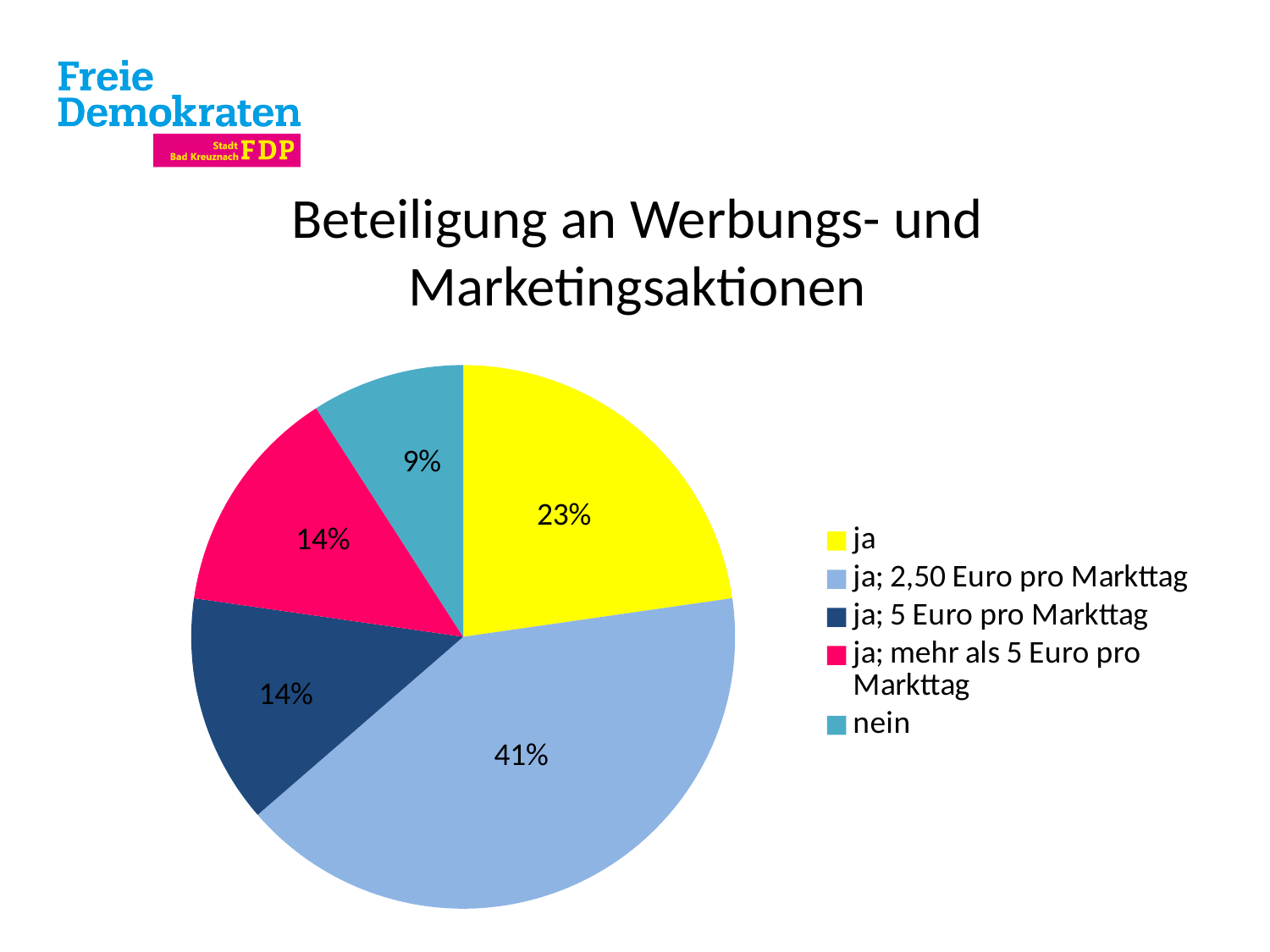
Which colour represents "nein" in the legend? teal What share of the pie is labelled "ja; 2,50 Euro pro Markttag"? 41% What share of the pie is labelled "ja"? 23% What share of the pie is labelled "nein"? 9% What is the title of the chart? Beteiligung an Werbungs- und Marketingsaktionen Which category has the largest slice of the pie? ja; 2,50 Euro pro Markttag What kind of chart is shown on the slide? pie chart Which category has the smallest slice of the pie? nein How many categories does the legend list? 5 Which is larger, the "ja" slice or the "nein" slice? ja What is the difference in percentage points between the "ja; 2,50 Euro pro Markttag" slice and the "ja" slice? 18